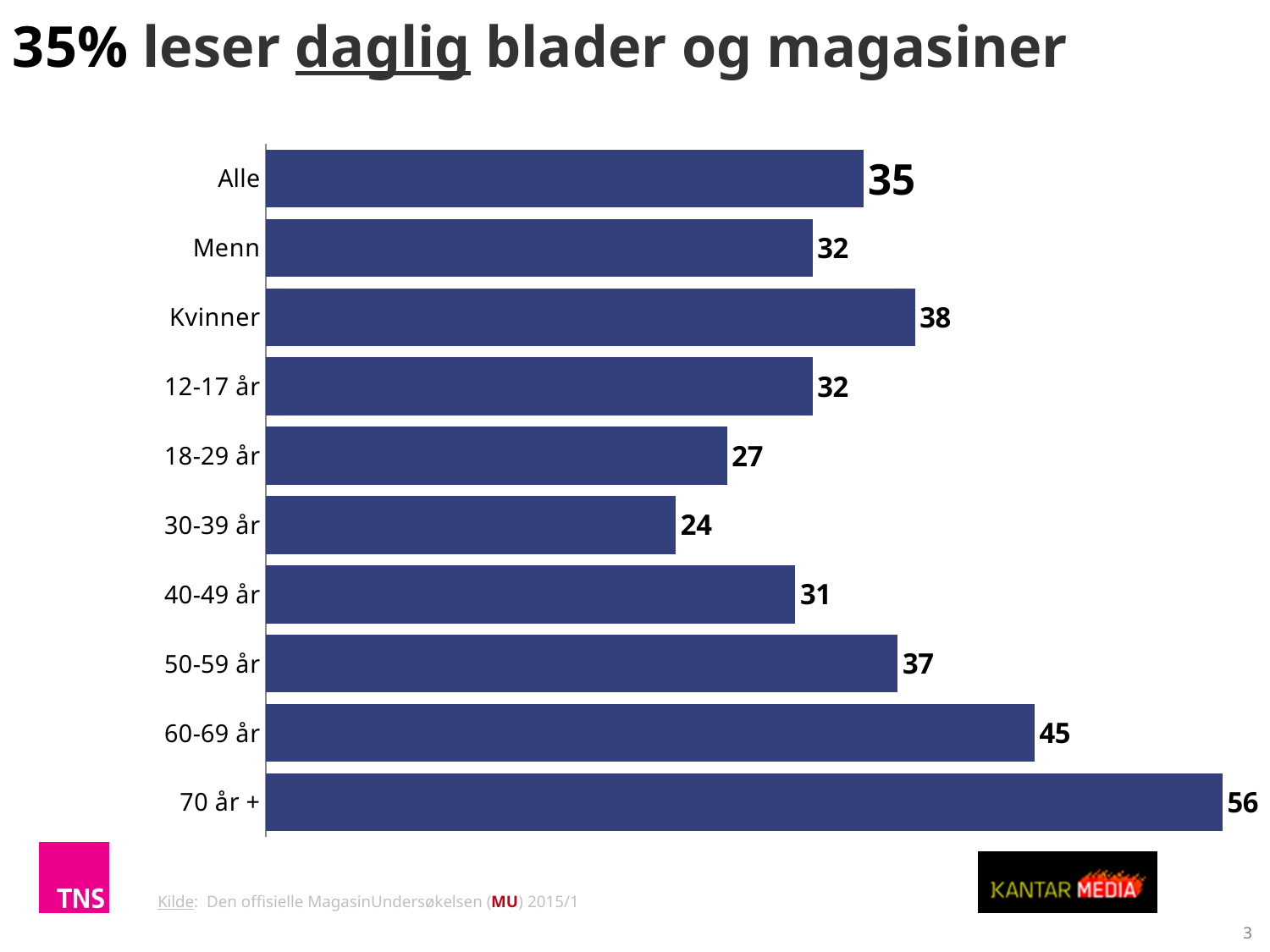
What is the title of the slide? 35% leser daglig blader og magasiner How many categories are shown in the chart? 10 Which category has the highest value? 70 år + What is the difference between the values for Kvinner and Menn? 6 Which is larger, the value for 50-59 år or the value for 40-49 år? 50-59 år What is the difference between the values for 70 år + and 60-69 år? 11 What kind of chart is shown on the slide? Bar chart Which category has the lowest value? 30-39 år Do the values rise or fall across the age groups from 30-39 år to 70 år +? Rise What is the value for Alle? 35 What is the value for Kvinner? 38 What is the value for 60-69 år? 45